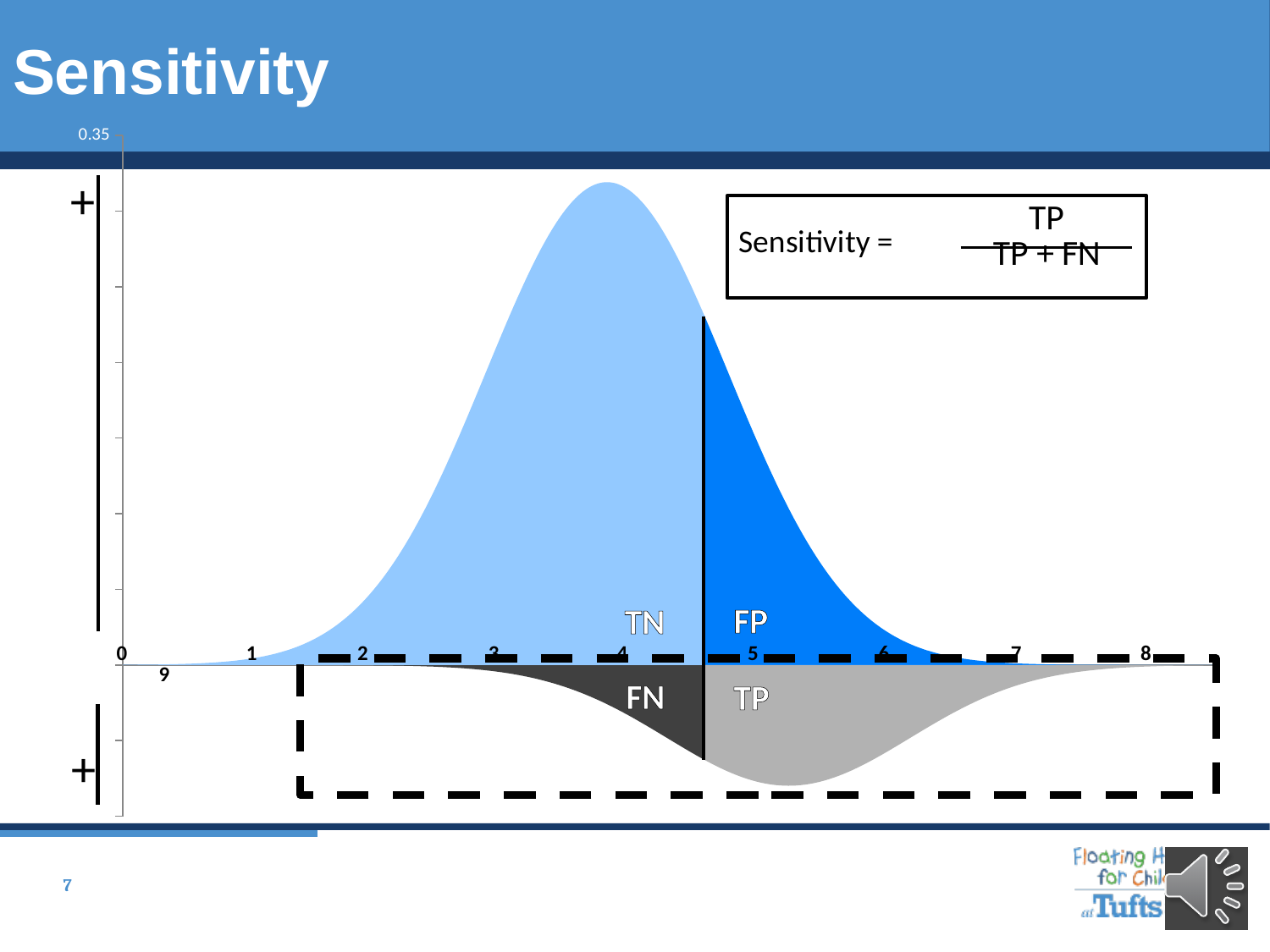
Does the upper curve rise or fall as x goes from 5 to 7? falls Which is larger, the height of the upper curve at x = 3 or at x = 7? at x = 3 Which region label appears below the x axis to the left of the vertical cutoff line? FN Which region label appears above the x axis to the right of the vertical cutoff line? FP What kind of chart is shown on the slide? area chart Is the peak of the upper curve greater or less than 0.35? less Which is larger, the depth of the lower curve at x = 5 or at x = 2? at x = 5 What is the value printed at the top of the y axis? 0.35 Does the upper curve rise or fall as x goes from 1 to 3? rises